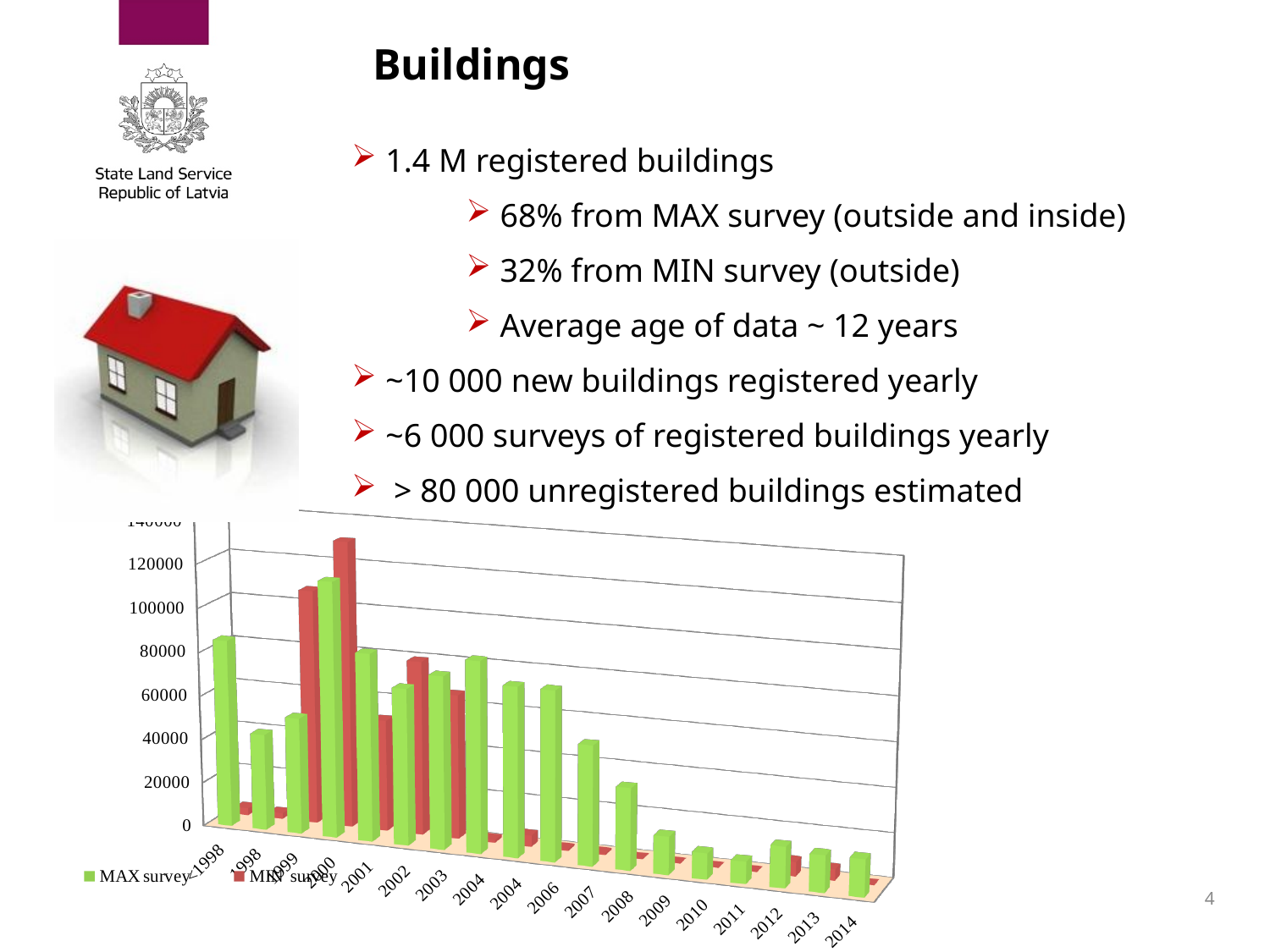
Is the MAX survey value for 2002 larger or smaller than the MAX survey value for 2008? larger What colour are the MAX survey bars in the chart? green What kind of chart is shown on the slide? bar chart In 2000, which series has the larger value, MAX survey or MIN survey? MIN survey What are the two series named in the chart legend? MAX survey and MIN survey How many year categories are shown along the x axis of the chart? 18 Is the MAX survey value for 2014 greater or less than 20000? less Is the MIN survey value for 2000 greater or less than 100000? greater Which year has the highest MIN survey value? 2000 Do the MAX survey values generally rise or fall from 2006 to 2014? fall How many series does the chart legend list? 2 Which year has the highest MAX survey value? 2000